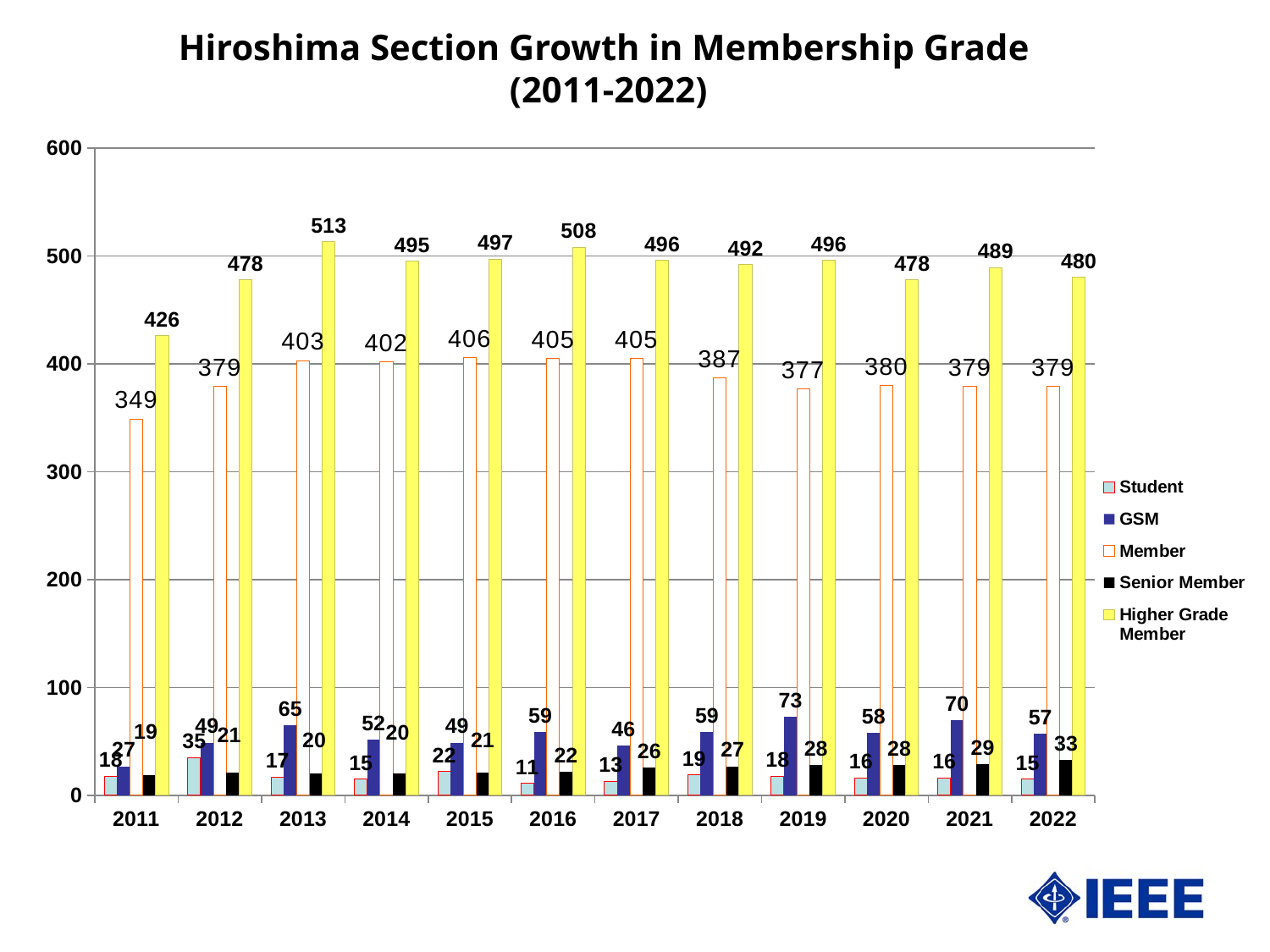
What kind of chart is shown on the slide? Bar chart What is the difference between the Higher Grade Member values for 2013 and 2011? 87 How many years are shown on the x axis? 12 How many series does the legend list? 5 What is the Higher Grade Member value for 2013? 513 What is the GSM value for 2019? 73 In which year is the Student value lowest? 2016 Which series is shown in yellow? Higher Grade Member What is the Member value for 2011? 349 What is the Senior Member value for 2022? 33 Which is larger, the Member value for 2015 or the Member value for 2019? 2015 In which year is the Higher Grade Member value highest? 2013